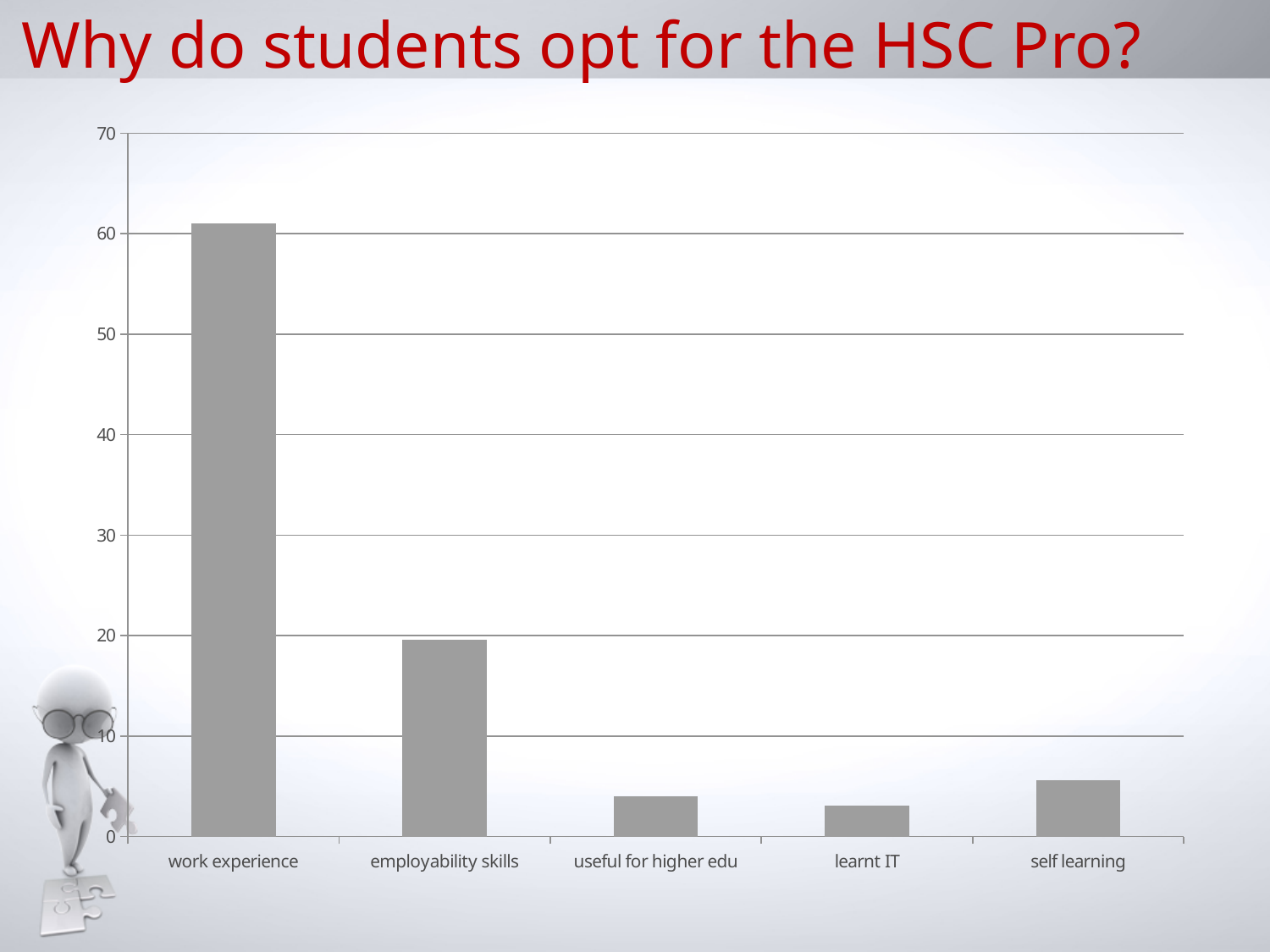
Is the value for work experience greater or less than 50? greater What is the highest value shown on the vertical axis of the chart? 70 What is the title of the slide containing the chart? Why do students opt for the HSC Pro? How many categories are shown on the x axis of the chart? 5 What kind of chart is shown on the slide? bar chart Is the value for self learning greater or less than 10? less Is the value for useful for higher edu greater or less than 10? less Which category has the highest bar in the chart? work experience Which is larger, the value for work experience or the value for employability skills? work experience Which is larger, the value for self learning or the value for learnt IT? self learning